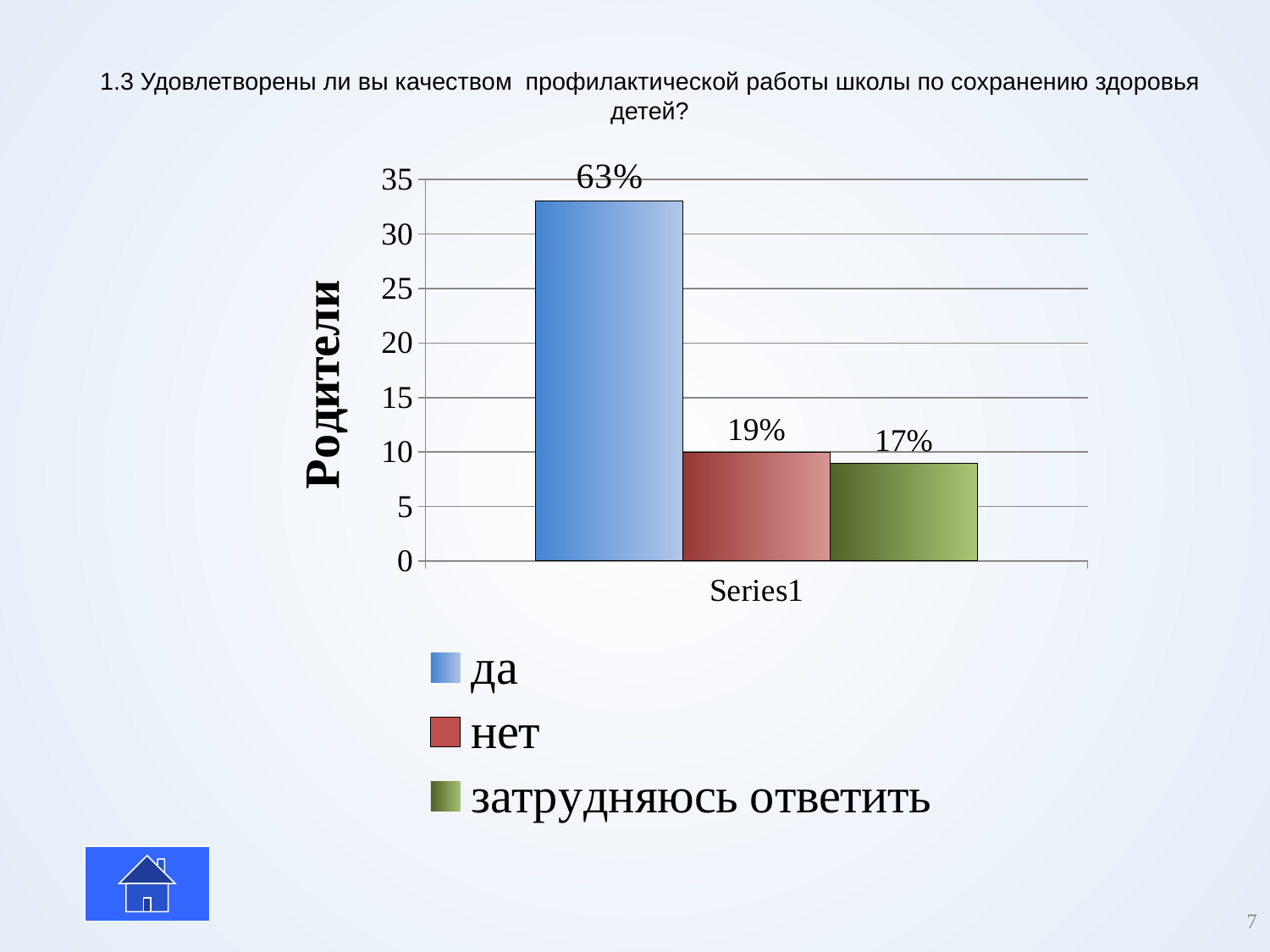
What is the difference between the data labels for "да" and "нет"? 44% Which answer option has the lowest bar? затрудняюсь ответить How many bars are plotted in the chart? 3 Is the value for "нет" on the vertical axis greater or less than 15? less How many entries does the legend list? 3 Is the value for "да" on the vertical axis greater or less than 30? greater Which answer option has the highest bar? да Which is larger, the bar for "нет" or the bar for "затрудняюсь ответить"? нет What data label is shown on the bar for "нет"? 19% What type of chart is shown on the slide? Bar chart What data label is shown on the bar for "да"? 63% What data label is shown on the bar for "затрудняюсь ответить"? 17%